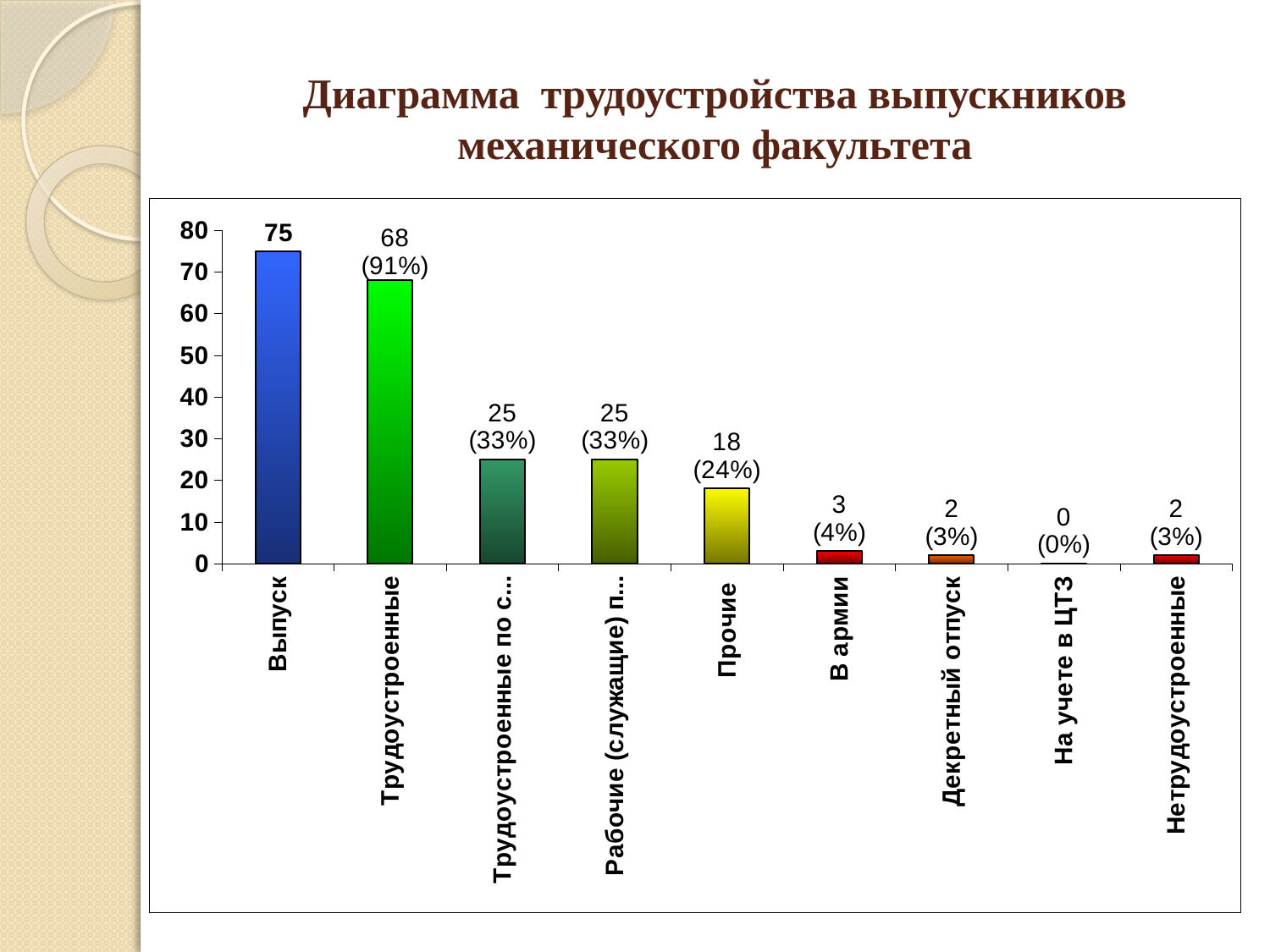
What is the value of the bar for В армии? 3 How many categories are shown on the x axis? 9 What type of chart is shown on the slide? Bar chart What is the value of the bar for Выпуск? 75 What is the value of the bar for Прочие? 18 What is the value of the bar for Декретный отпуск? 2 Which category has the lowest value? На учете в ЦТЗ What is the difference between the values for Выпуск and Трудоустроенные? 7 Which is larger, the value for Прочие or the value for В армии? Прочие What is the value of the bar for Трудоустроенные? 68 Which category has the highest bar? Выпуск What is the difference between the values for Трудоустроенные and Прочие? 50